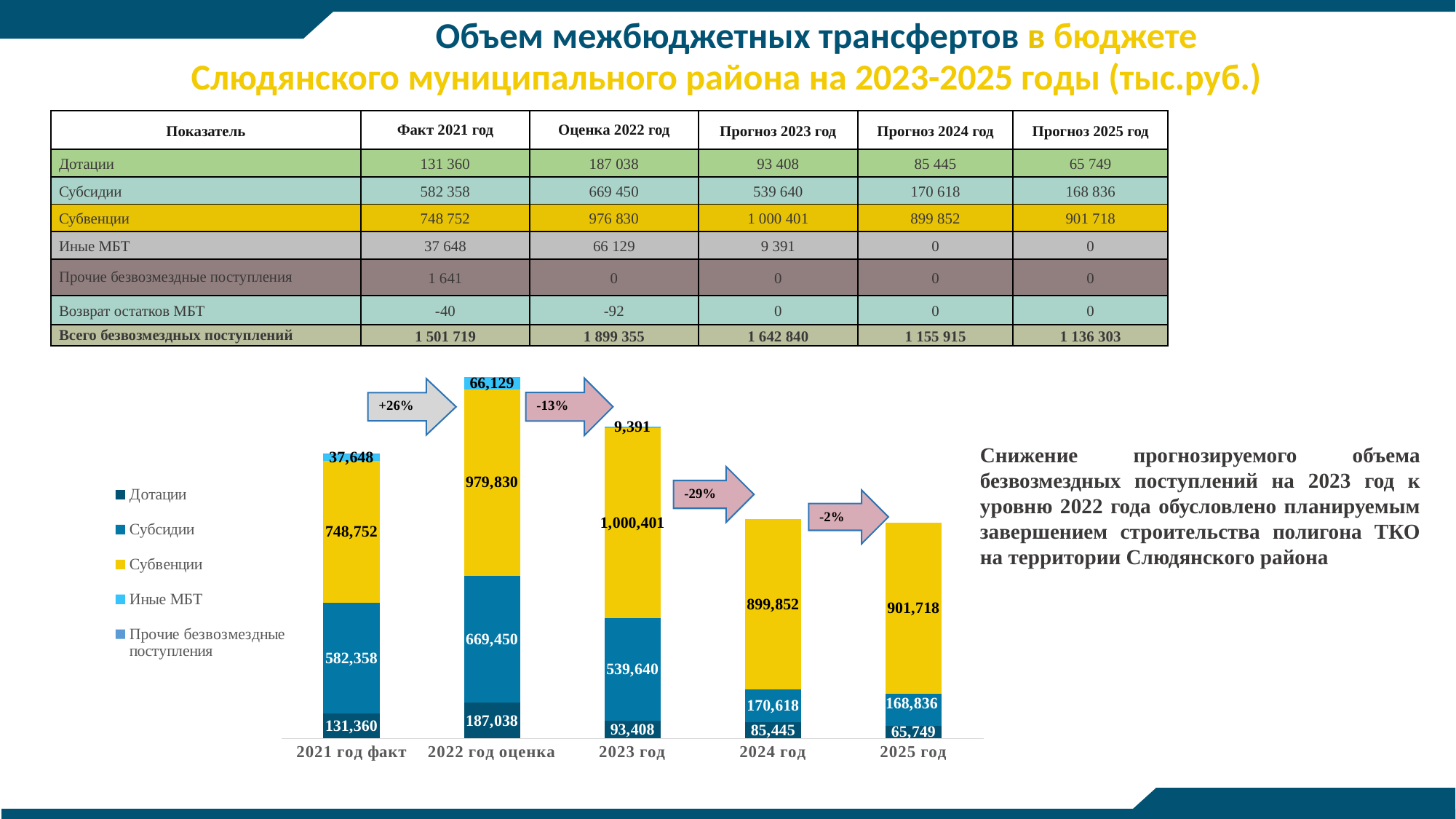
Which is larger in the chart: Субсидии for 2021 год факт or Субсидии for 2022 год оценка? 2022 год оценка How many year categories are plotted on the x axis of the chart? 5 In which year is the Дотации value lowest in the chart? 2025 год Do the Субсидии values rise or fall from 2022 год оценка to 2025 год in the chart? fall How many series does the chart legend list? 5 What is the value of Субсидии for 2025 год in the chart? 168,836 What is the difference between the Субвенции values for 2023 год and 2024 год in the chart? 100,549 What is the value of Иные МБТ for 2022 год оценка in the chart? 66,129 What is the value of Субвенции for 2023 год in the chart? 1,000,401 What is the total of the stacked bar for 2024 год in the chart? 1,155,915 In which year is the Дотации value highest in the chart? 2022 год оценка What kind of chart is shown on the slide? stacked bar chart